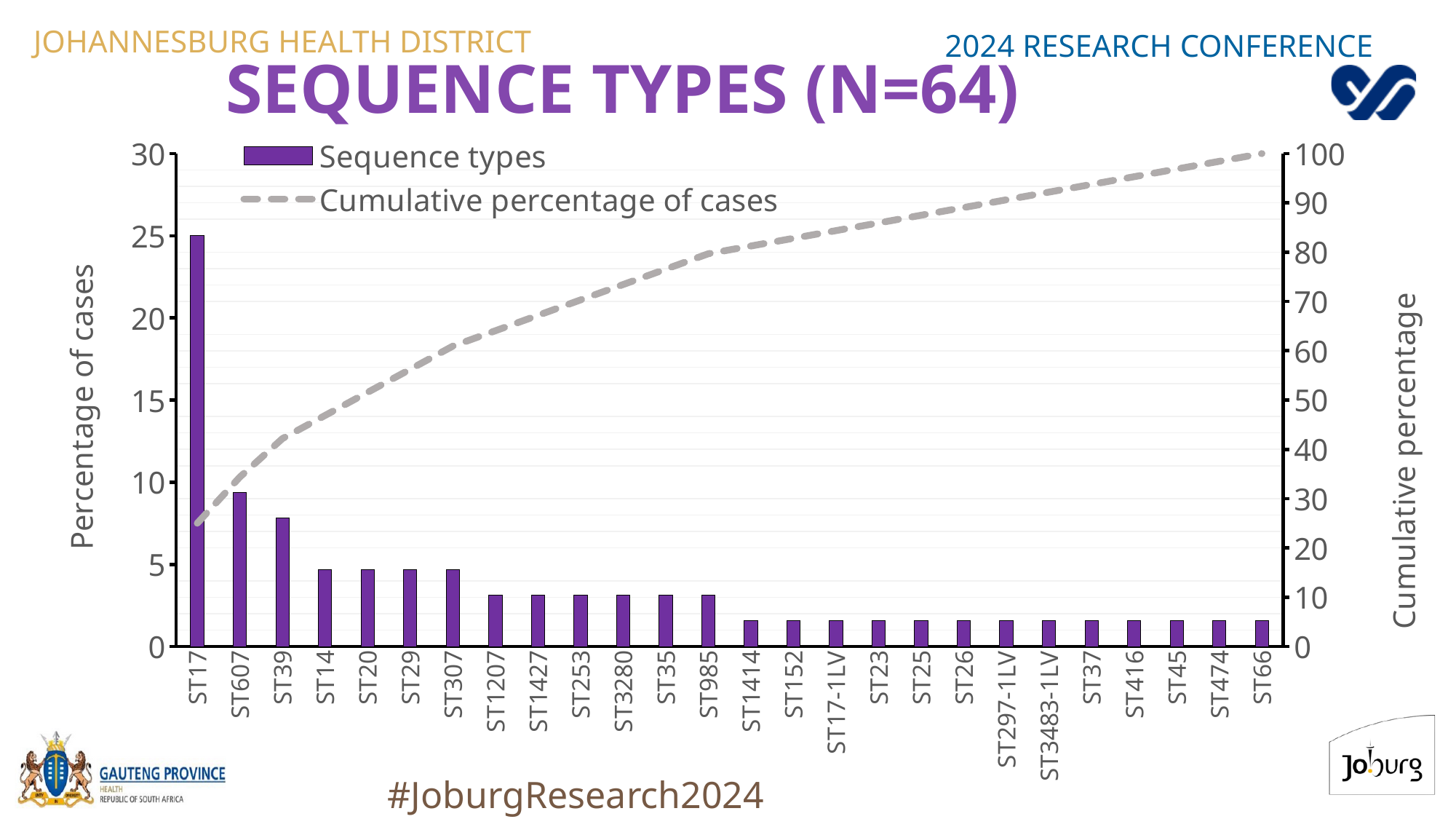
How many series does the legend list? 2 How many sequence types are shown on the x axis? 26 What kind of chart is used to show the sequence types? bar chart What is the percentage of cases for ST17? 25 Which sequence type has the highest percentage of cases? ST17 Which has a higher percentage of cases, ST607 or ST39? ST607 What is the label of the right-hand vertical axis? Cumulative percentage What is the title of the chart? SEQUENCE TYPES (N=64) Is the percentage of cases for ST39 greater or less than 10? less Do the bar values rise or fall from left to right along the x axis? fall Is the percentage of cases for ST607 greater or less than 5? greater